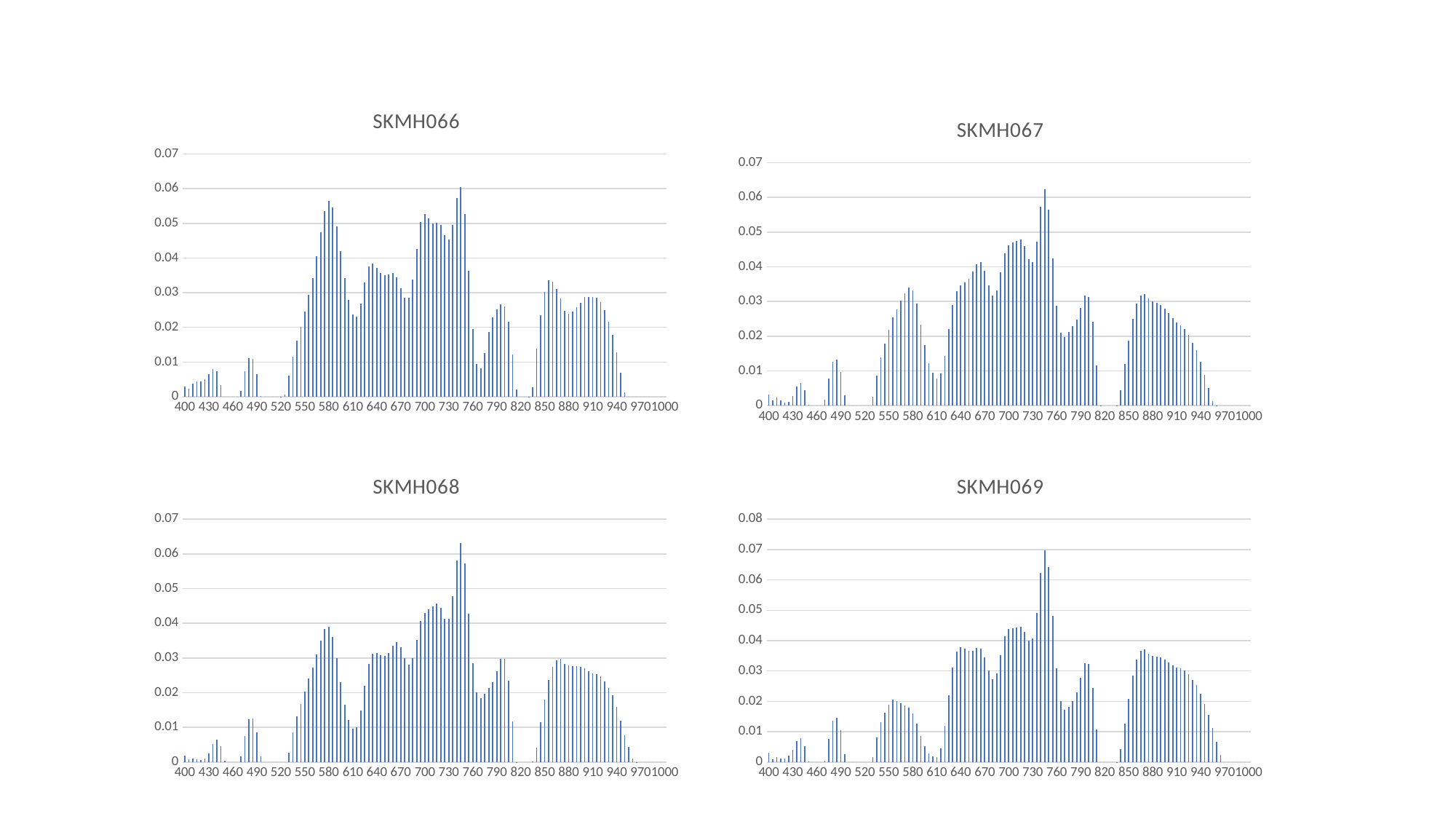
In the SKMH067 chart, is the value at 550 greater or less than 0.04? less In the SKMH069 chart, is the value at 760 larger or smaller than the value at 400? larger What kind of chart is SKMH066? bar chart What is the title of the chart in the bottom-right position? SKMH069 In the SKMH066 chart, is the value at 400 greater or less than 0.01? less In the SKMH066 chart, do the values rise or fall between 520 and 580? rise How many charts are shown on the slide? 4 In the SKMH067 chart, do the values rise or fall between 880 and 940? fall In the SKMH068 chart, is the value at 880 greater or less than 0.02? greater In the SKMH069 chart, what is the highest value shown on the y axis? 0.08